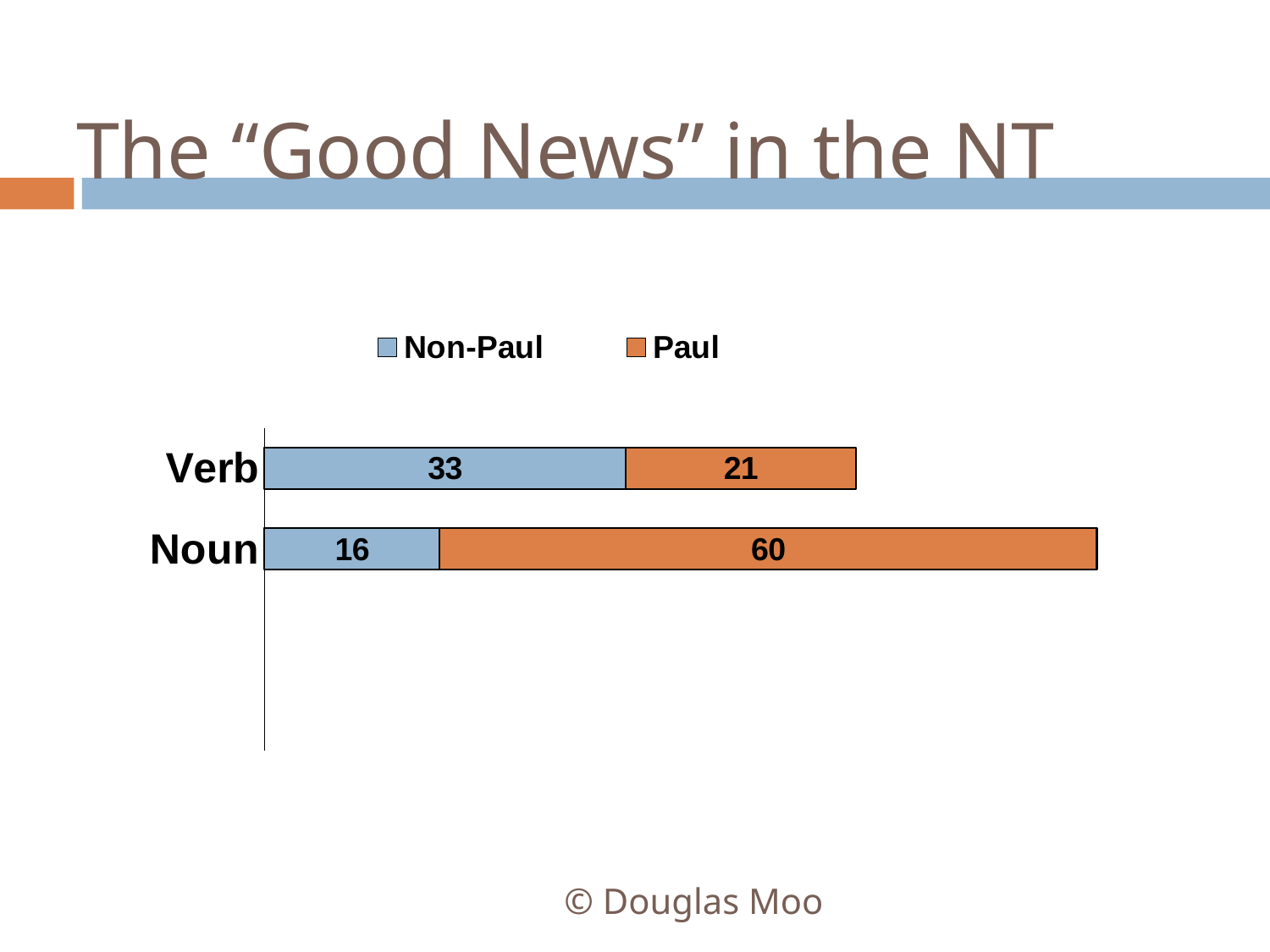
What is the difference between the Paul value for Noun and the Paul value for Verb? 39 What kind of chart is shown on the slide? Stacked bar chart What is the total of the stacked bar for Noun? 76 What is the total of the stacked bar for Verb? 54 What is the Paul value for Verb? 21 What is the Non-Paul value for Verb? 33 Which category has the higher Non-Paul value, Verb or Noun? Verb Which category has the higher Paul value, Verb or Noun? Noun What is the Non-Paul value for Noun? 16 How many categories are shown on the chart? 2 How many series does the legend list? 2 What is the Paul value for Noun? 60